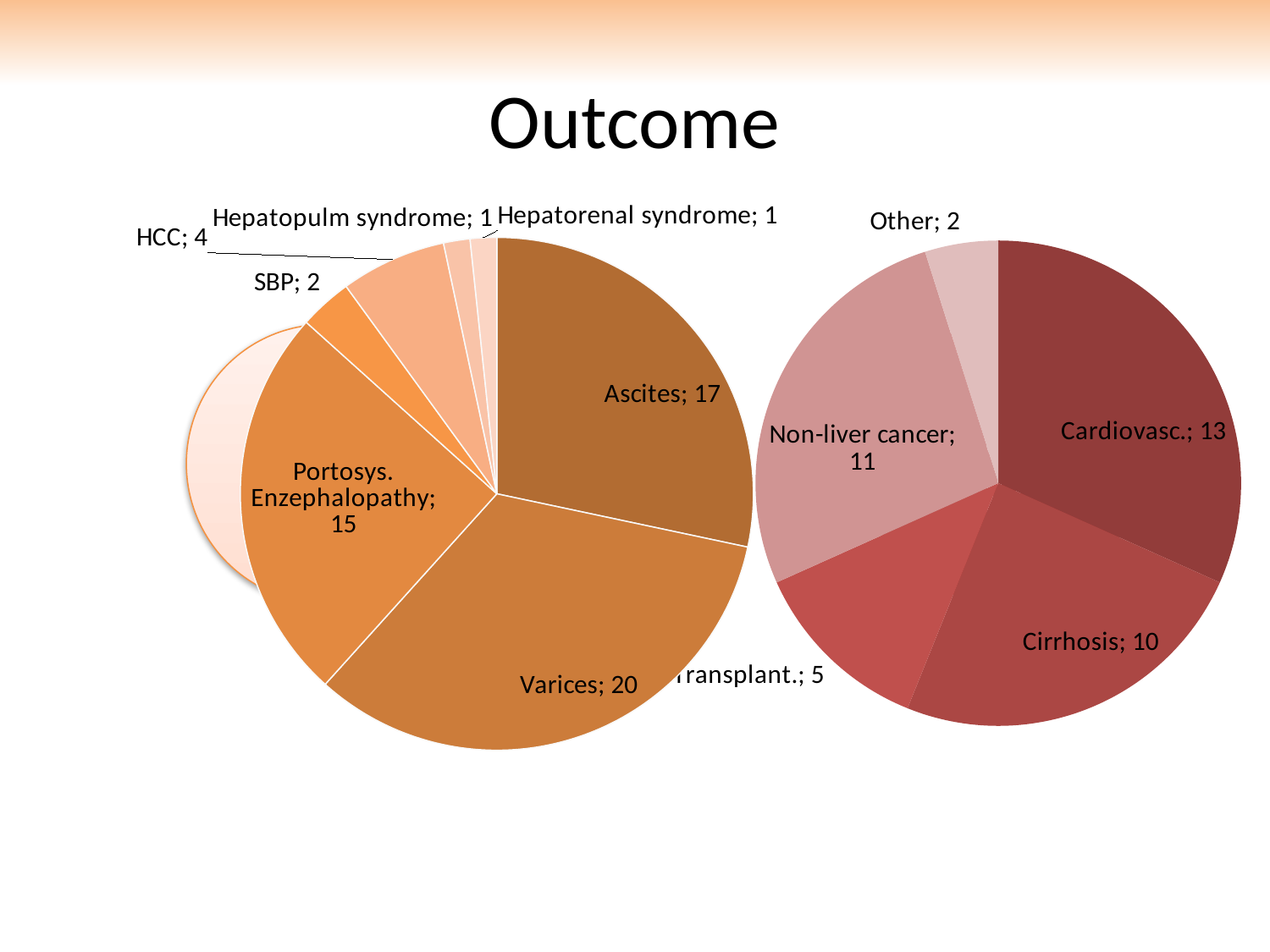
In the left pie chart, what is the difference between Varices and Portosys. Enzephalopathy? 5 What type of chart is used on this slide? Pie chart In the left pie chart, what is the value for Portosys. Enzephalopathy? 15 In the left pie chart, what is the value for Varices? 20 In the left pie chart, which is larger: Ascites or Portosys. Enzephalopathy? Ascites In the left pie chart, which category has the largest slice? Varices In the right pie chart, what is the value for Cardiovasc.? 13 In the right pie chart, what is the difference between Cardiovasc. and Cirrhosis? 3 How many labeled categories does the left pie chart show? 7 In the left pie chart, what is the value for Ascites? 17 In the right pie chart, what is the value for Cirrhosis? 10 In the right pie chart, what is the value for Non-liver cancer? 11